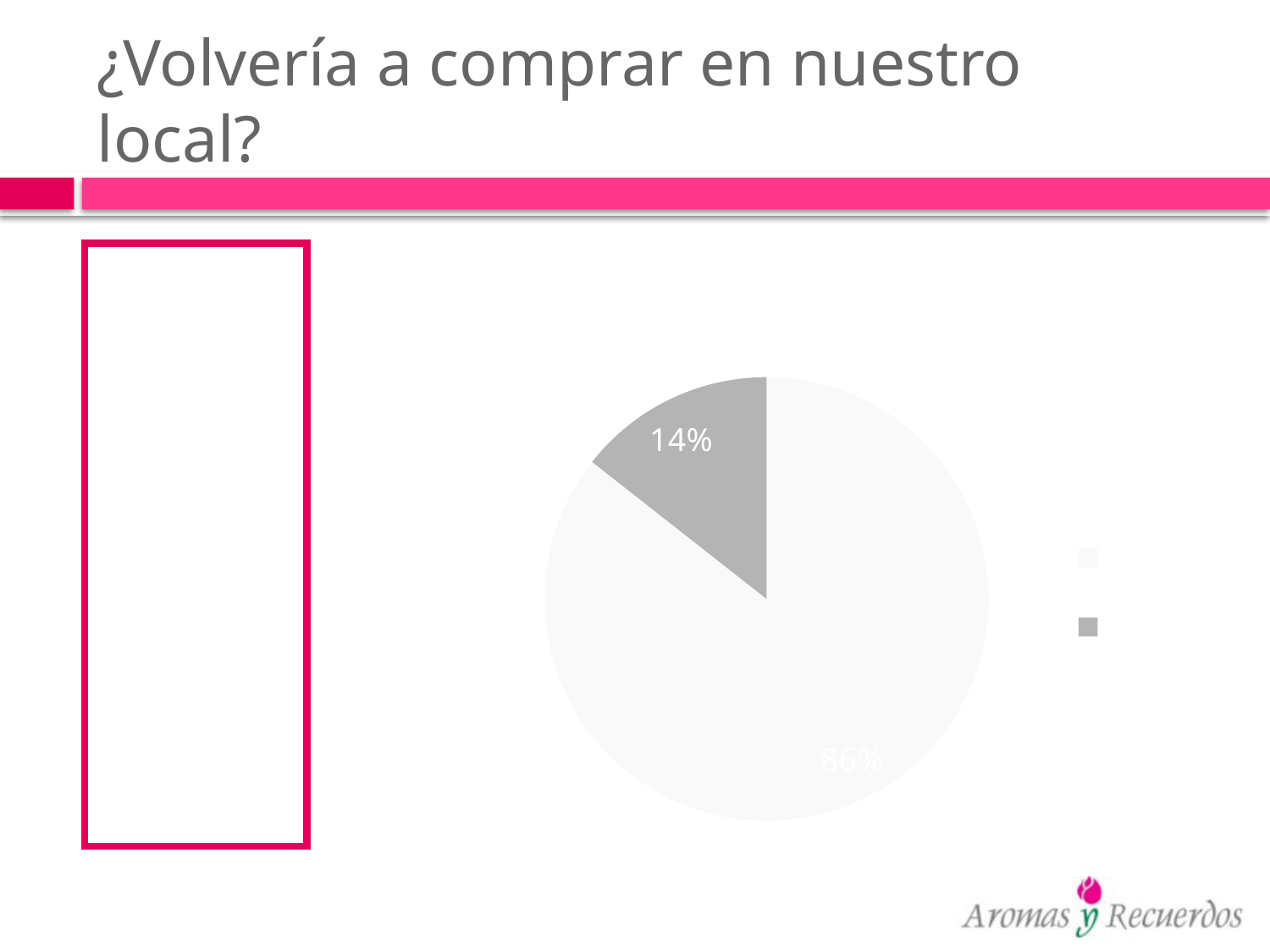
What is the share of the largest slice in the pie chart? 86% What percentage is shown on the gray slice of the pie chart? 14% What question does the slide title ask above the pie chart? ¿Volvería a comprar en nuestro local? What percentage is shown on the larger, light-coloured slice of the pie chart? 86% What is the total of the two slice percentages shown on the pie chart? 100% What is the difference in percentage points between the two slices of the pie chart? 72 How many entries does the legend of the pie chart show? 2 Is the gray slice of the pie chart greater or less than 50%? less What is the share of the smallest slice in the pie chart? 14% What kind of chart is shown on the slide? Pie chart How many slices does the pie chart have? 2 Which slice is larger in the pie chart, the gray slice or the light-coloured slice? The light-coloured slice